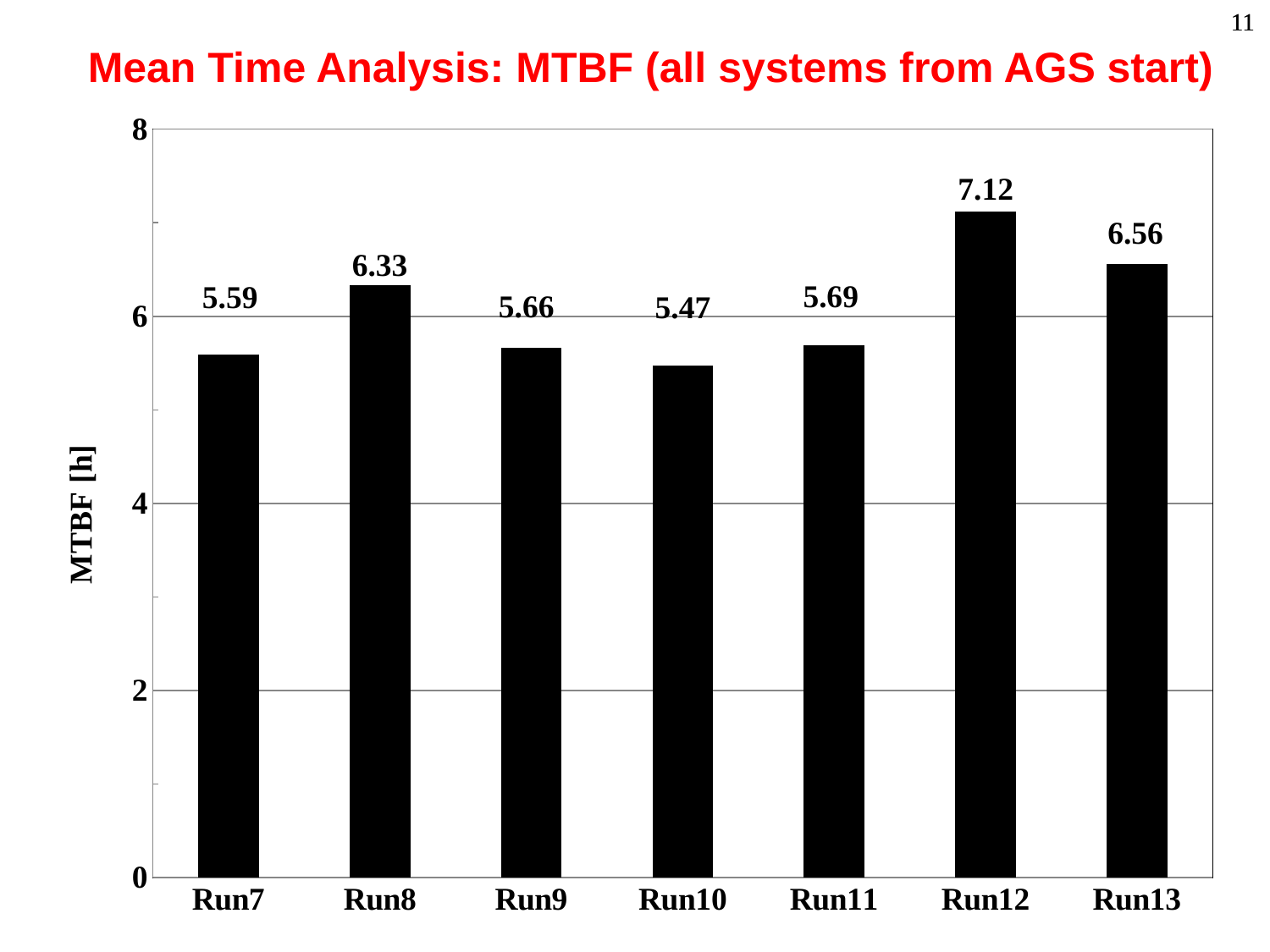
What is the MTBF value for Run8? 6.33 What is the MTBF value for Run13? 6.56 What is the difference in MTBF between Run8 and Run7? 0.74 What is the difference in MTBF between Run12 and Run13? 0.56 What kind of chart is shown on the slide? bar chart How many runs are shown in the chart? 7 Is the MTBF value for Run12 greater or less than 6? greater What is the label of the y axis? MTBF [h] Which run has the lowest MTBF? Run10 Which has a higher MTBF, Run8 or Run11? Run8 What is the MTBF value for Run10? 5.47 Which run has the highest MTBF? Run12